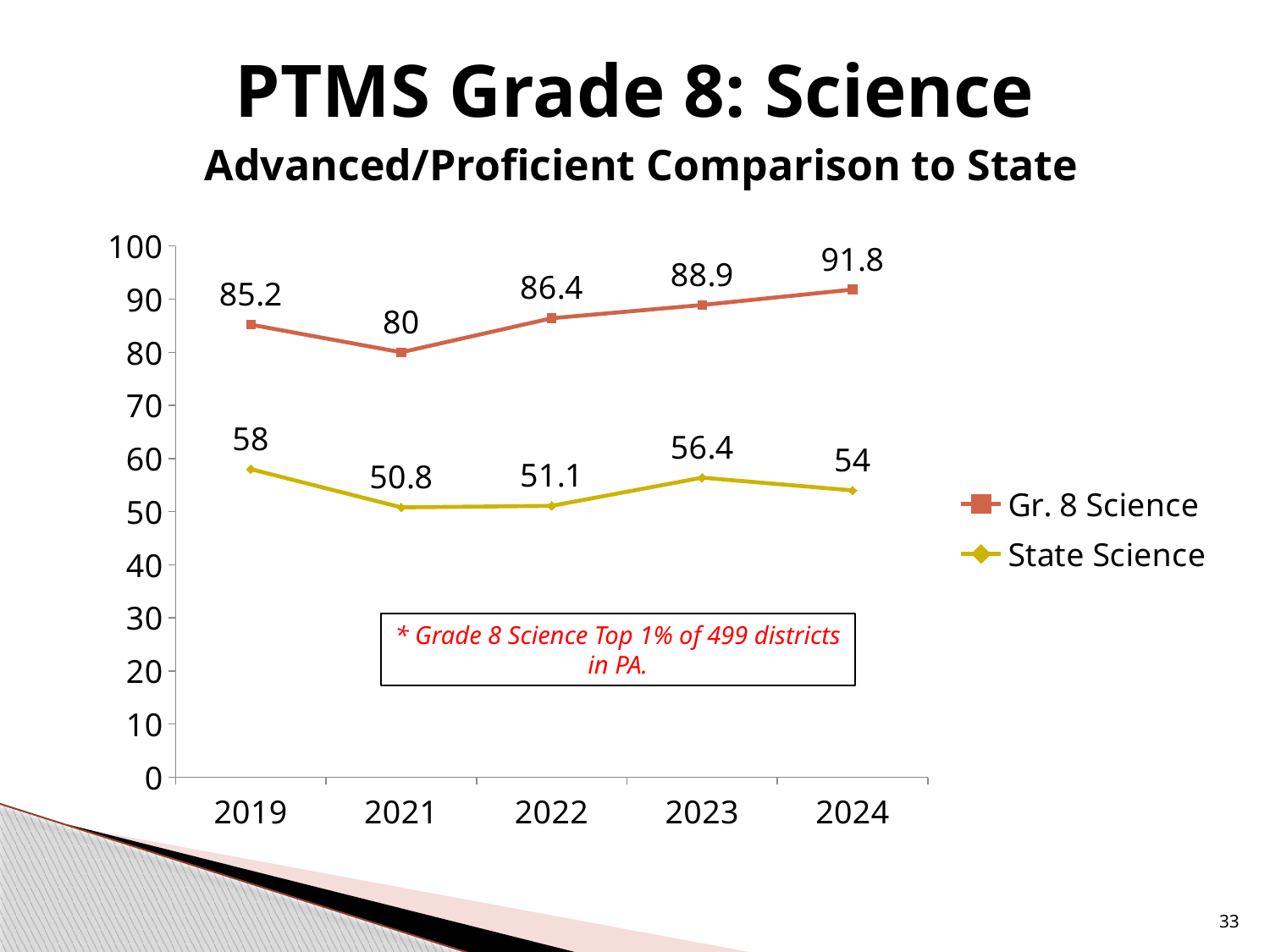
Which is larger in 2023: the Gr. 8 Science value or the State Science value? Gr. 8 Science In which year is the State Science value lowest? 2021 Does the Gr. 8 Science value rise or fall from 2021 to 2024? Rise What is the State Science value for 2021? 50.8 What is the Gr. 8 Science value for 2024? 91.8 What is the subtitle of the chart? Advanced/Proficient Comparison to State How many years are shown on the x axis? 5 How many series does the legend list? 2 What is the Gr. 8 Science value for 2021? 80 What is the difference between the Gr. 8 Science and State Science values in 2024? 37.8 What kind of chart is shown on the slide? Line chart In which year is the Gr. 8 Science value highest? 2024